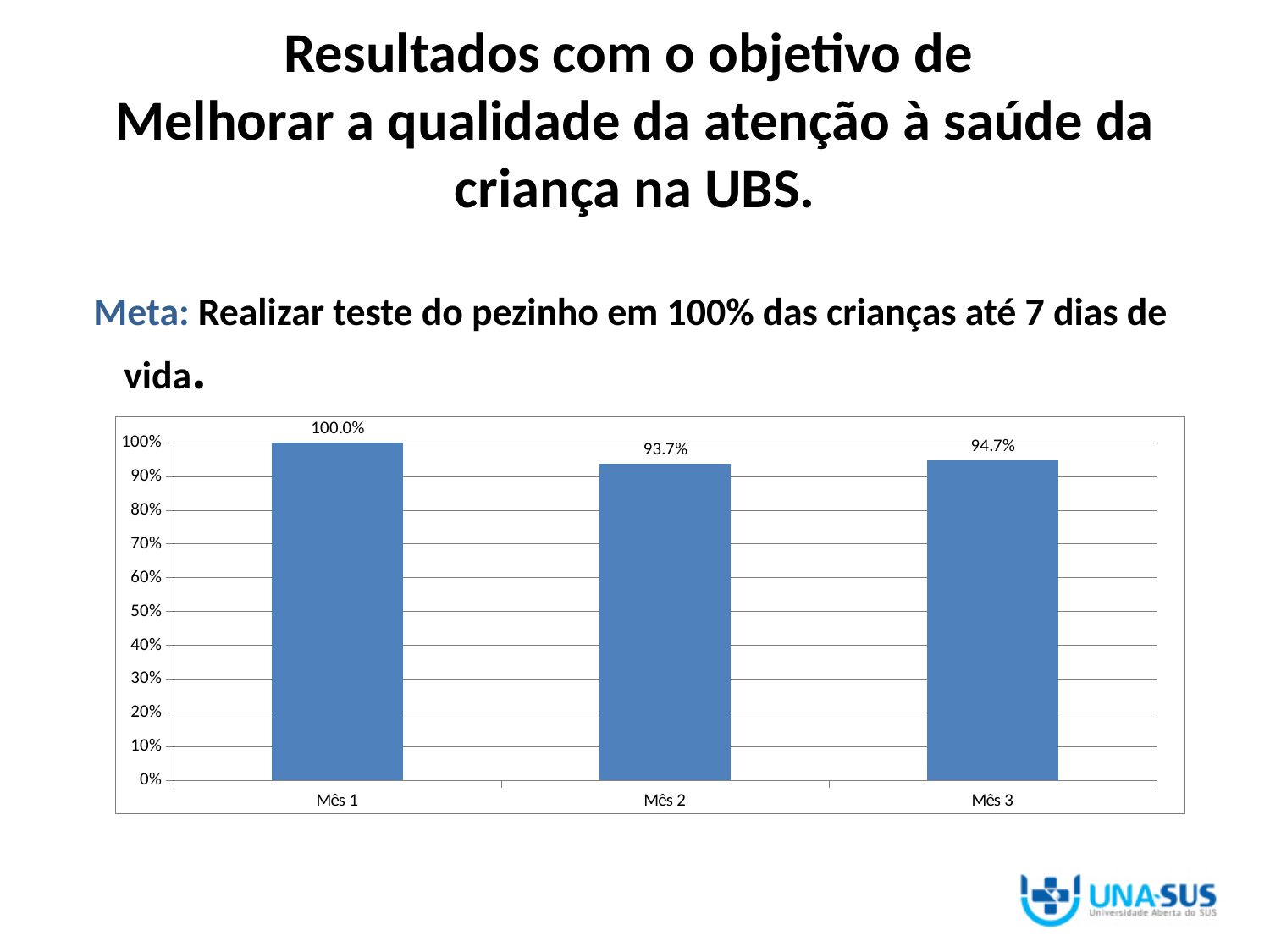
What kind of chart is shown on the slide? bar chart What is the value for Mês 1? 100.0% Which is larger, the value for Mês 1 or the value for Mês 3? Mês 1 What is the value for Mês 3? 94.7% Which month has the highest value? Mês 1 Which month has the lowest value? Mês 2 How many months are shown on the x axis? 3 What is the difference between the values for Mês 3 and Mês 2? 1.0% What is the value for Mês 2? 93.7% What is the difference between the values for Mês 1 and Mês 2? 6.3% Is the value for Mês 2 greater or less than 90%? greater What is the highest tick value shown on the y axis? 100%